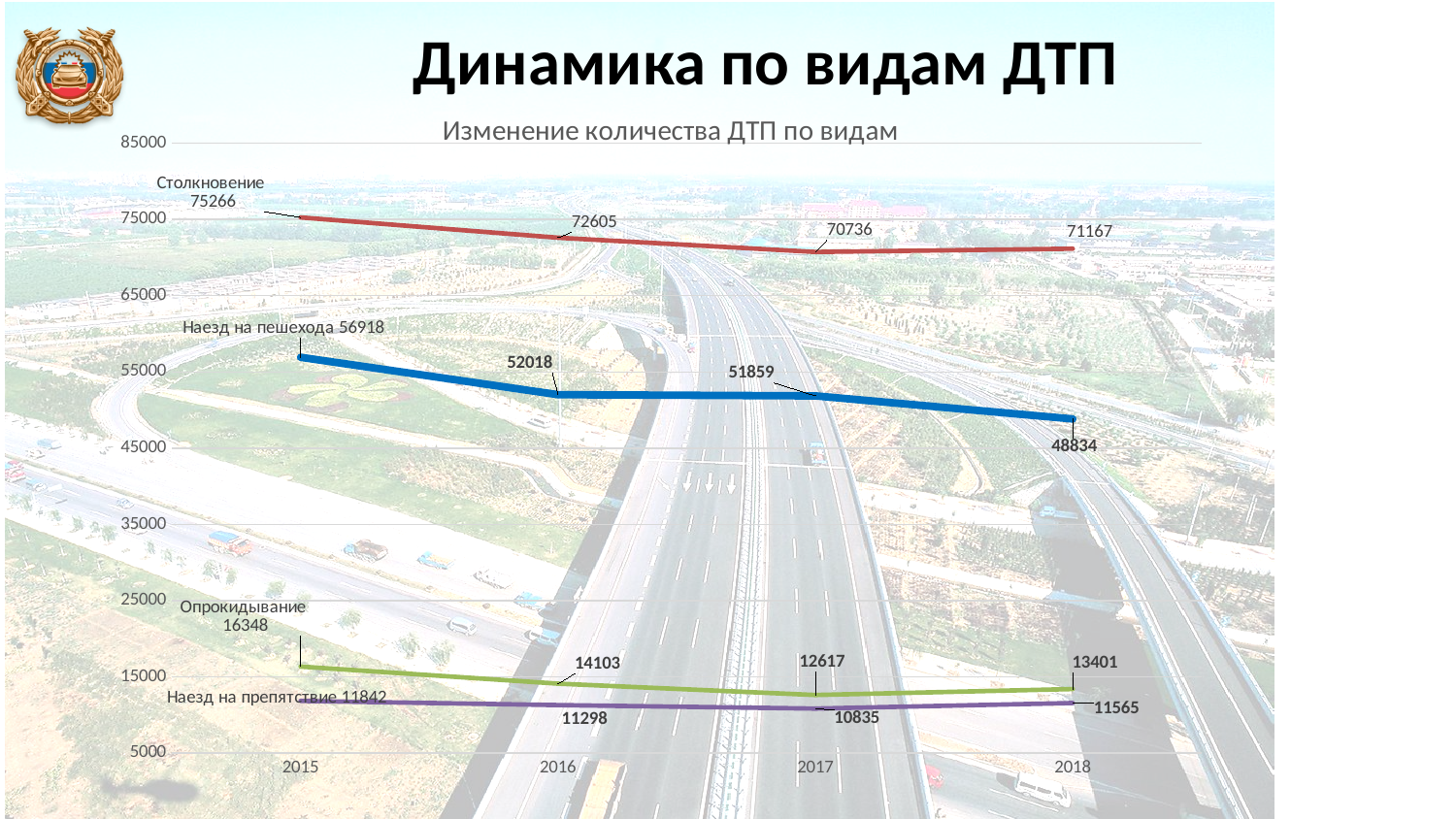
How many series are plotted on the chart? 4 What is the value for Столкновение in 2015? 75266 What is the value for Наезд на пешехода in 2018? 48834 Does the value for Наезд на пешехода rise or fall from 2015 to 2018? fall In which year is the value for Столкновение lowest? 2017 What is the value for Наезд на препятствие in 2016? 11298 How many years are shown on the x axis? 4 What is the difference between the Столкновение values in 2015 and 2018? 4099 Which is larger: Опрокидывание in 2018 or Наезд на препятствие in 2018? Опрокидывание in 2018 In which year is the value for Наезд на пешехода highest? 2015 What type of chart is shown on the slide? line chart What is the value for Опрокидывание in 2017? 12617